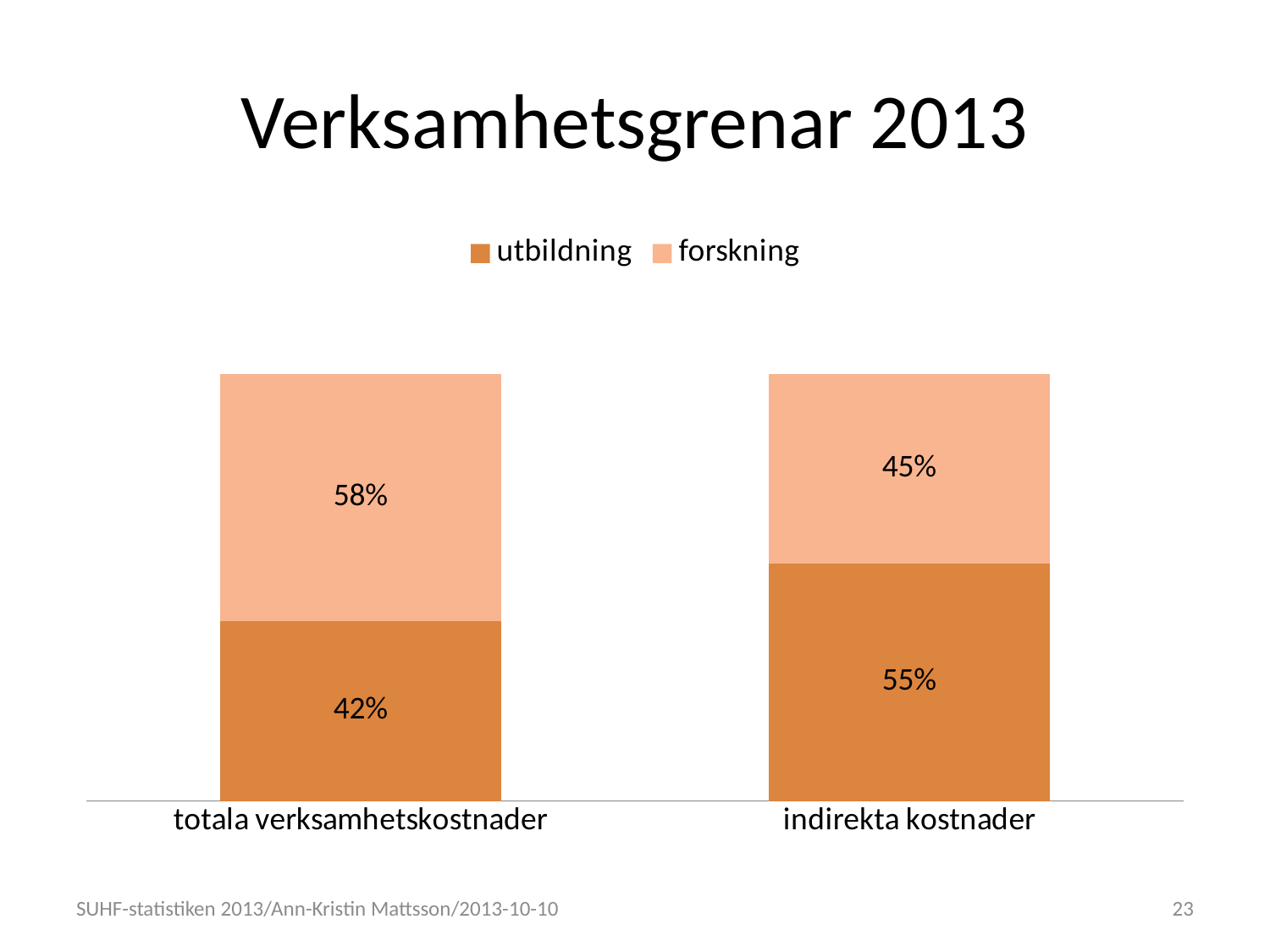
What is the value for utbildning in the totala verksamhetskostnader bar? 42% Which category has the lower value for forskning? indirekta kostnader What is the difference between the utbildning values for indirekta kostnader and totala verksamhetskostnader? 13% How many series does the legend list? 2 What is the value for forskning in the indirekta kostnader bar? 45% What kind of chart is shown on the slide? stacked bar chart What is the value for utbildning in the indirekta kostnader bar? 55% What is the value for forskning in the totala verksamhetskostnader bar? 58% Which category has the higher value for utbildning? indirekta kostnader Is the forskning value larger for totala verksamhetskostnader or for indirekta kostnader? totala verksamhetskostnader How many categories are shown on the x axis? 2 What is the difference between the forskning and utbildning values for totala verksamhetskostnader? 16%